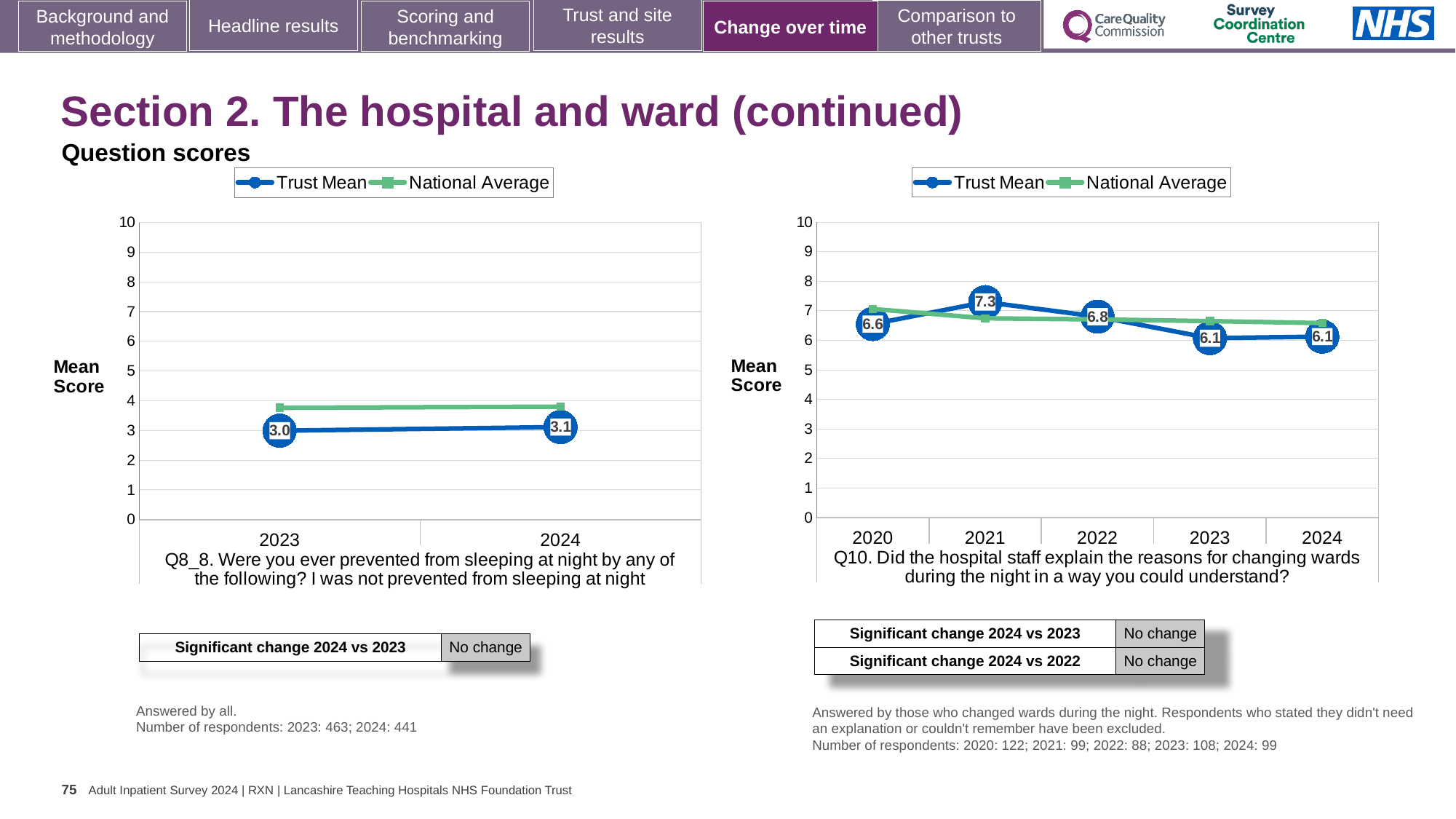
In the Q8_8 chart on the left, what is the Trust Mean score for 2024? 3.1 In the Q10 chart on the right, is the Trust Mean score for 2020 larger or smaller than the score for 2022? smaller In the Q10 chart on the right, which year has the highest Trust Mean score? 2021 In the Q10 chart on the right, what is the Trust Mean score for 2021? 7.3 In the Q8_8 chart on the left, what is the Trust Mean score for 2023? 3.0 In the Q10 chart on the right, what is the Trust Mean score for 2024? 6.1 What type of chart is the Q10 chart on the right? Line chart In the Q10 chart on the right, how many years are shown on the x axis? 5 In the Q8_8 chart on the left, how many series does the legend list? 2 In the Q10 chart on the right, what is the difference between the Trust Mean scores for 2021 and 2023? 1.2 In the Q8_8 chart on the left, is the National Average value for 2024 greater or less than 3? greater In the Q10 chart on the right, does the Trust Mean score rise or fall from 2021 to 2023? fall